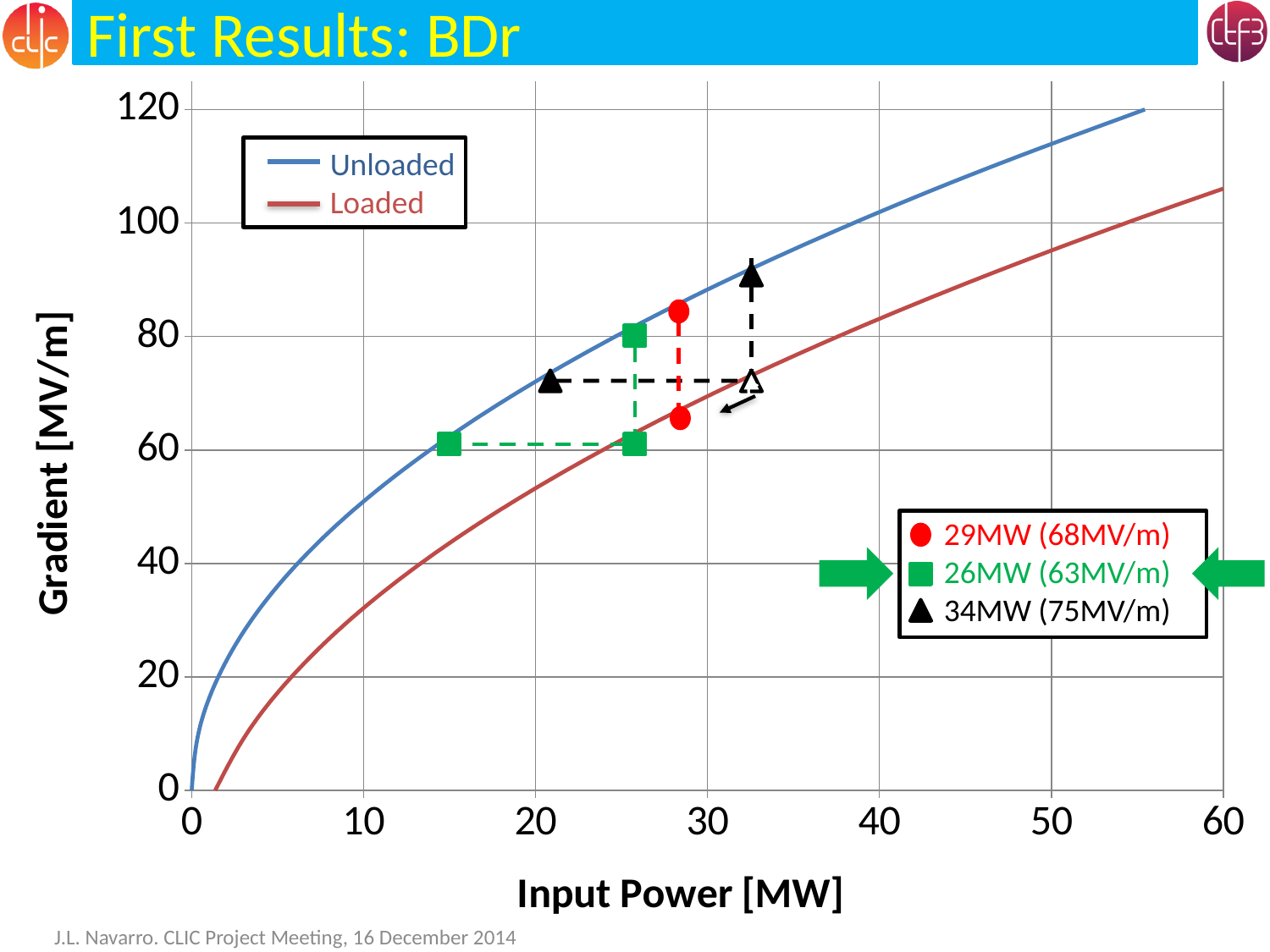
What is the label of the y axis of the chart? Gradient [MV/m] At an input power of 20 MW, which curve is higher, Unloaded or Loaded? Unloaded What kind of chart is shown on the slide? line chart According to the annotation box, what input power corresponds to the green square marker? 26MW What is the difference in gradient between the 34MW point and the 26MW point in the annotation box? 12MV/m How many series does the chart legend list? 2 At an input power of 20 MW, is the Loaded curve greater or less than 60 MV/m? less Do the Unloaded and Loaded gradient curves rise or fall as input power increases? rise According to the annotation box, what gradient corresponds to the red circle marker at 29MW? 68MV/m According to the annotation box, what gradient corresponds to the black triangle marker at 34MW? 75MV/m What are the two series named in the chart legend? Unloaded and Loaded Of the three annotated operating points, which has the highest input power? 34MW (75MV/m)